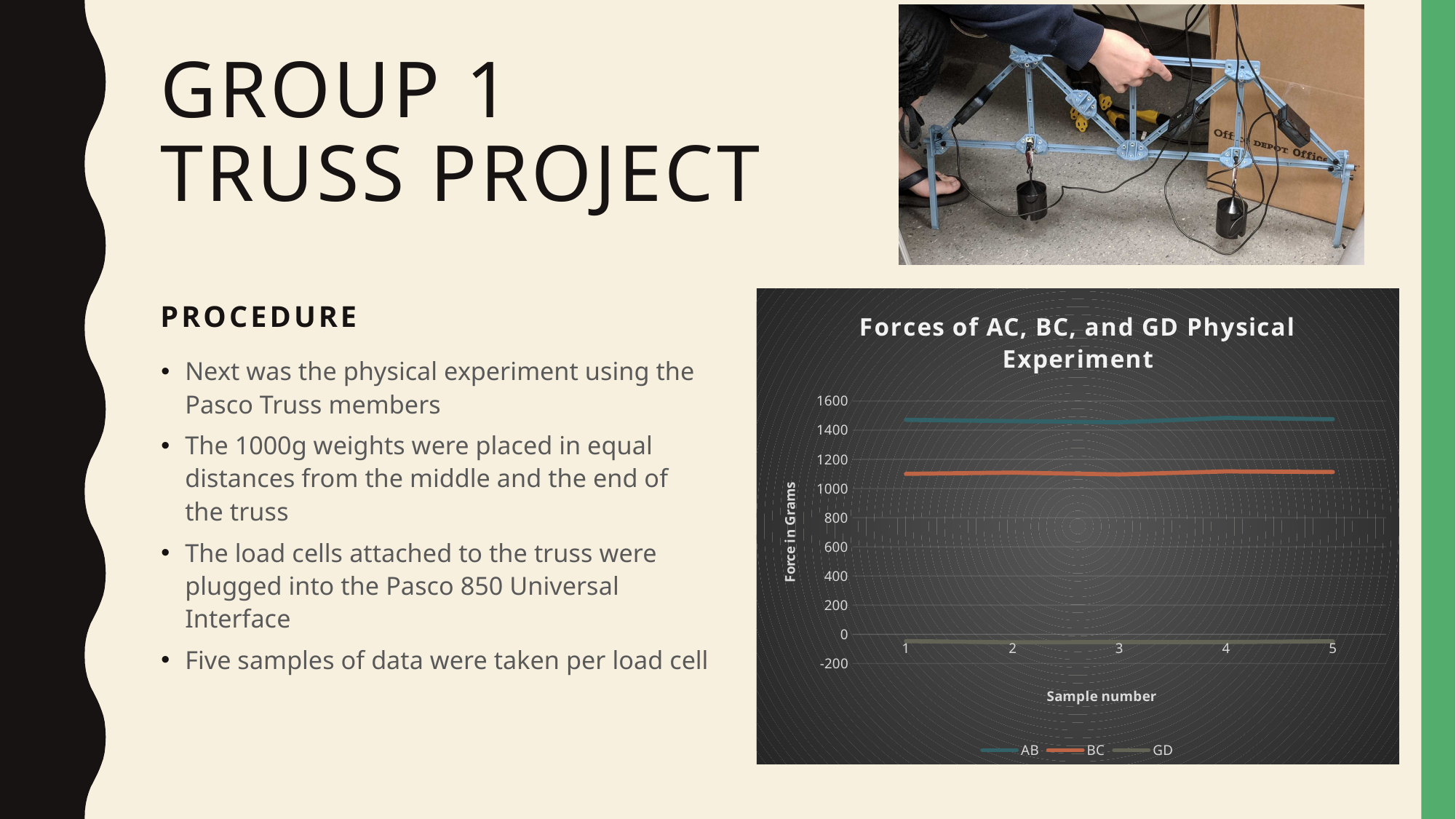
Is the value for GD at sample 2 greater or less than 200? less What kind of chart is shown on the slide? Line chart How many sample numbers are plotted along the x axis? 5 How many series does the chart legend list? 3 Is the value for BC at sample 5 greater or less than 1000? greater Is the value for AB at sample 1 greater or less than 1400? greater What is the title of the chart? Forces of AC, BC, and GD Physical Experiment Which series has the highest force values in the chart? AB What is the label of the vertical axis of the chart? Force in Grams Which series has the lowest force values in the chart? GD Which is larger at sample 4, the value for AB or the value for BC? AB